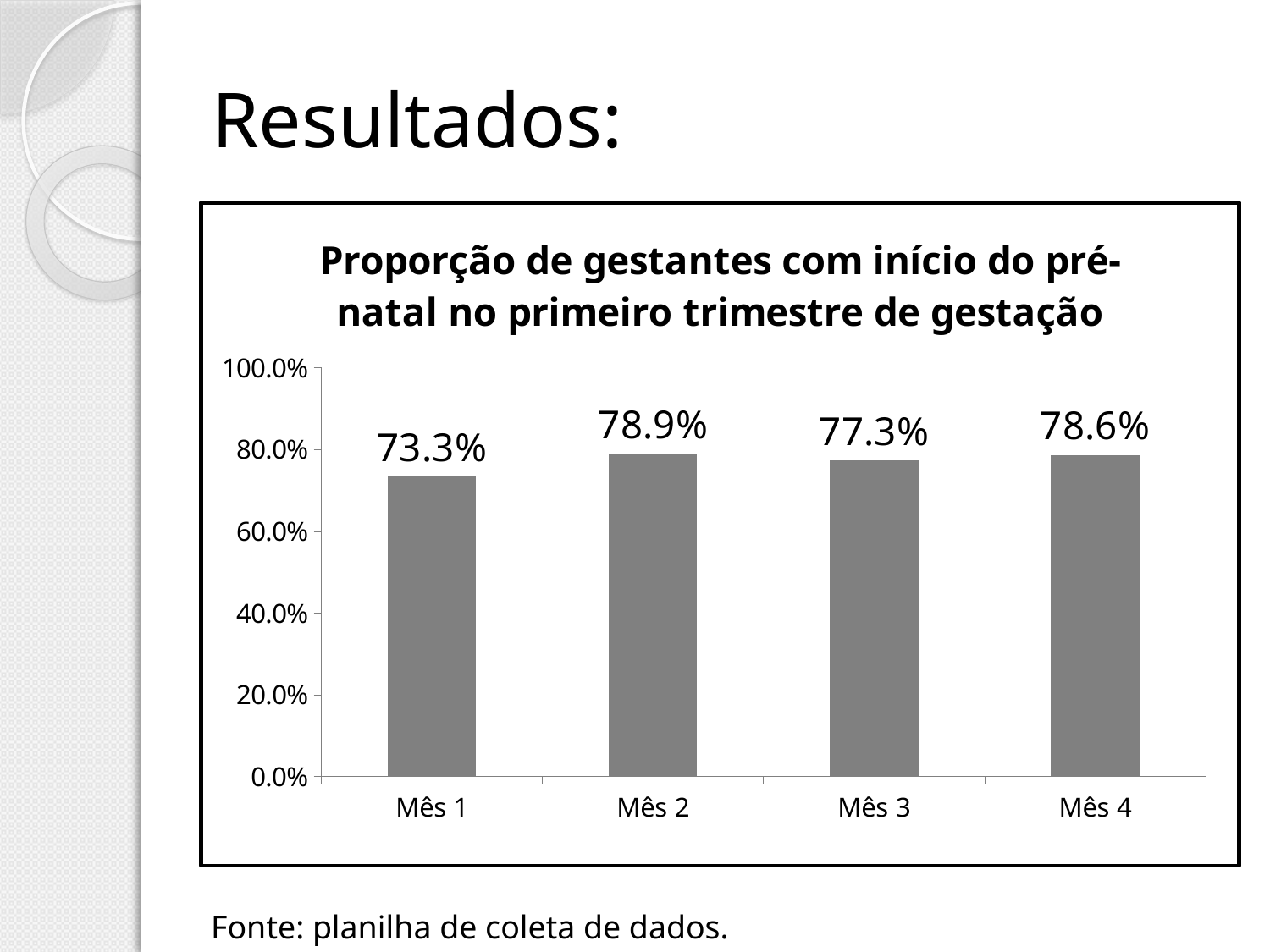
What is the value for Mês 4? 78.6% Which is larger, the value for Mês 1 or the value for Mês 3? Mês 3 What is the value for Mês 2? 78.9% What is the difference between the values for Mês 4 and Mês 3? 1.3% What is the value for Mês 1? 73.3% Which month has the highest value? Mês 2 What is the title of the chart? Proporção de gestantes com início do pré-natal no primeiro trimestre de gestação What is the difference between the values for Mês 2 and Mês 1? 5.6% What kind of chart is shown on the slide? Bar chart How many months are shown on the x axis? 4 Which month has the lowest value? Mês 1 What is the value for Mês 3? 77.3%